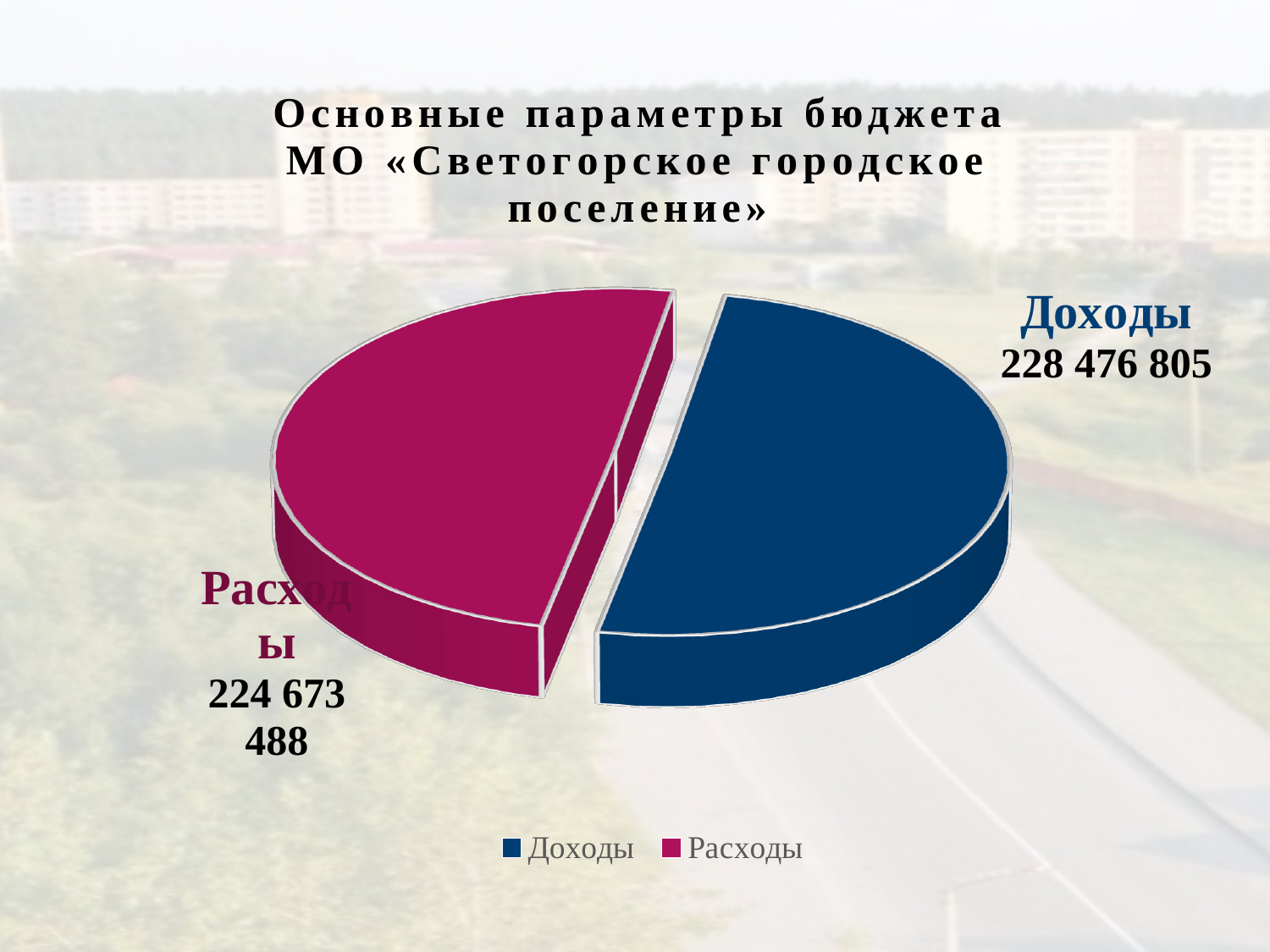
How many entries does the legend list? 2 How many slices does the pie chart have? 2 What is the value for Доходы? 228 476 805 What is the title of the chart? Основные параметры бюджета МО «Светогорское городское поселение» What is the difference between the values for Доходы and Расходы? 3 803 317 Which slice of the pie has the largest value? Доходы Which slice of the pie has the smallest value? Расходы What is the value for Расходы? 224 673 488 Which category has the larger value, Доходы or Расходы? Доходы What is the total of the two values shown in the pie chart? 453 150 293 What kind of chart is shown on the slide? Pie chart What colour is the Расходы slice? Magenta (crimson)